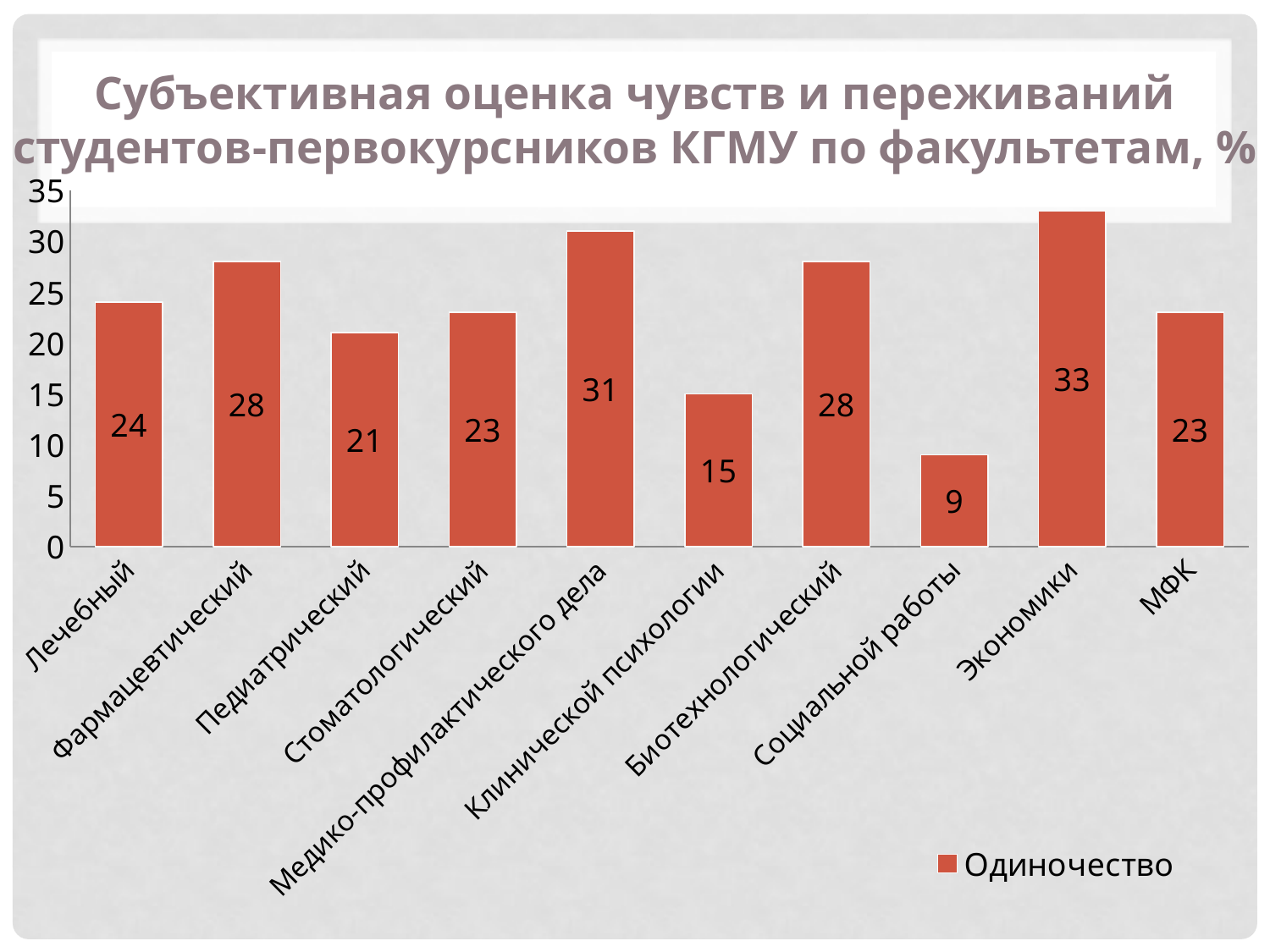
Which faculty has the lowest value? Социальной работы Is the value for Биотехнологический greater or less than 25? greater What is the value for Медико-профилактического дела? 31 How many faculties are shown on the x axis? 10 How many series does the legend list? 1 Which is larger, the value for Фармацевтический or the value for Педиатрический? Фармацевтический What is the value for Лечебный? 24 What kind of chart is this? bar chart What is the name of the series in the legend? Одиночество What is the value for Социальной работы? 9 Which faculty has the highest value? Экономики What is the difference between the values for Экономики and Клинической психологии? 18